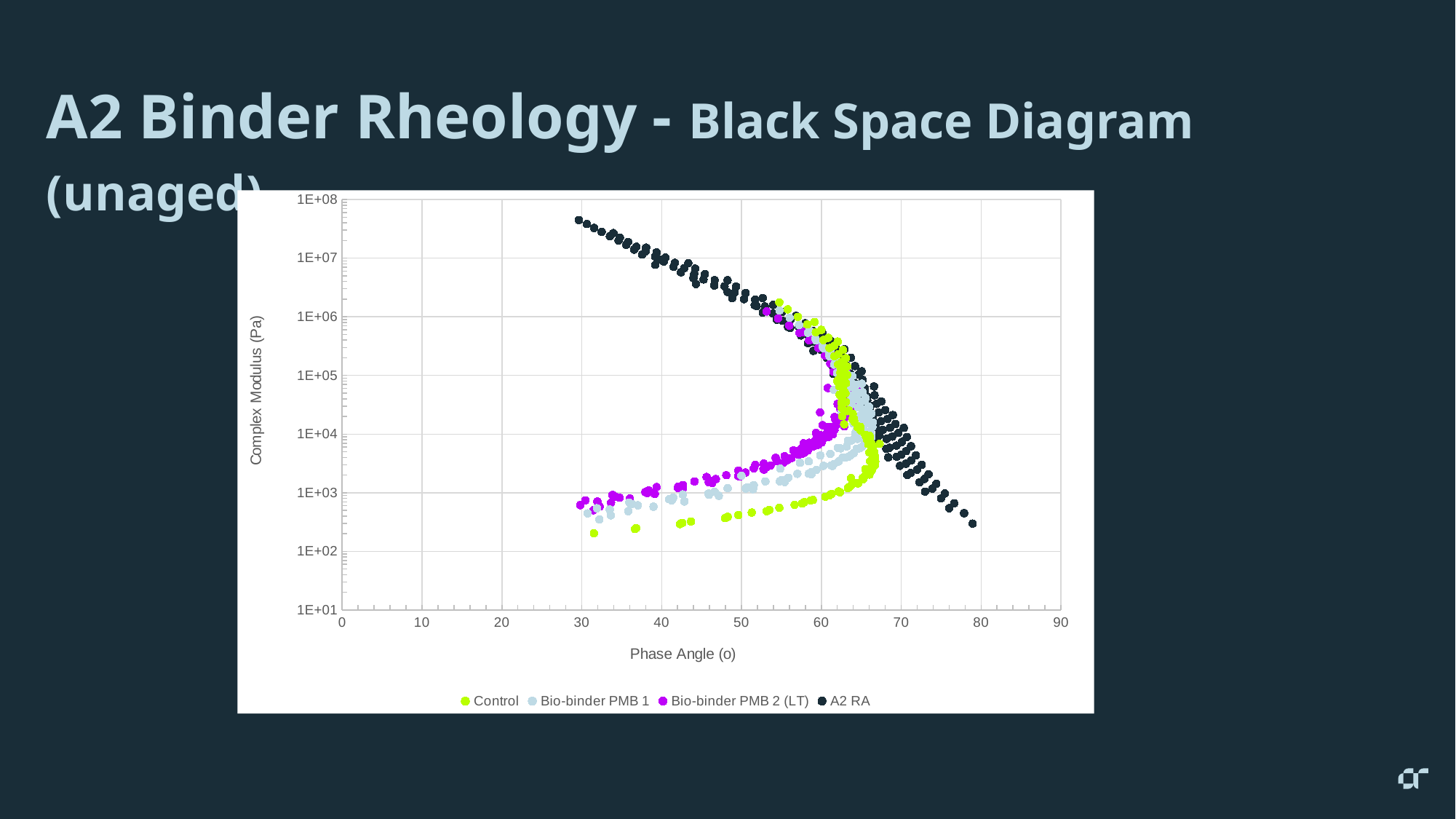
In the A2 RA series, does complex modulus rise or fall as phase angle increases? fall What are the series names listed in the legend? Control, Bio-binder PMB 1, Bio-binder PMB 2 (LT), A2 RA Is the maximum phase angle reached by the Control series greater or less than 70? less Is the lowest complex modulus of the Control series greater or less than 1E+03? less What is the title of the vertical axis? Complex Modulus (Pa) Which series reaches the highest complex modulus value? A2 RA What kind of chart is shown on the slide? Scatter chart Is the highest complex modulus of the A2 RA series greater or less than 1E+07? greater How many series does the legend list? 4 Which series extends to the highest phase angle? A2 RA Which series contains the point with the lowest complex modulus? Control